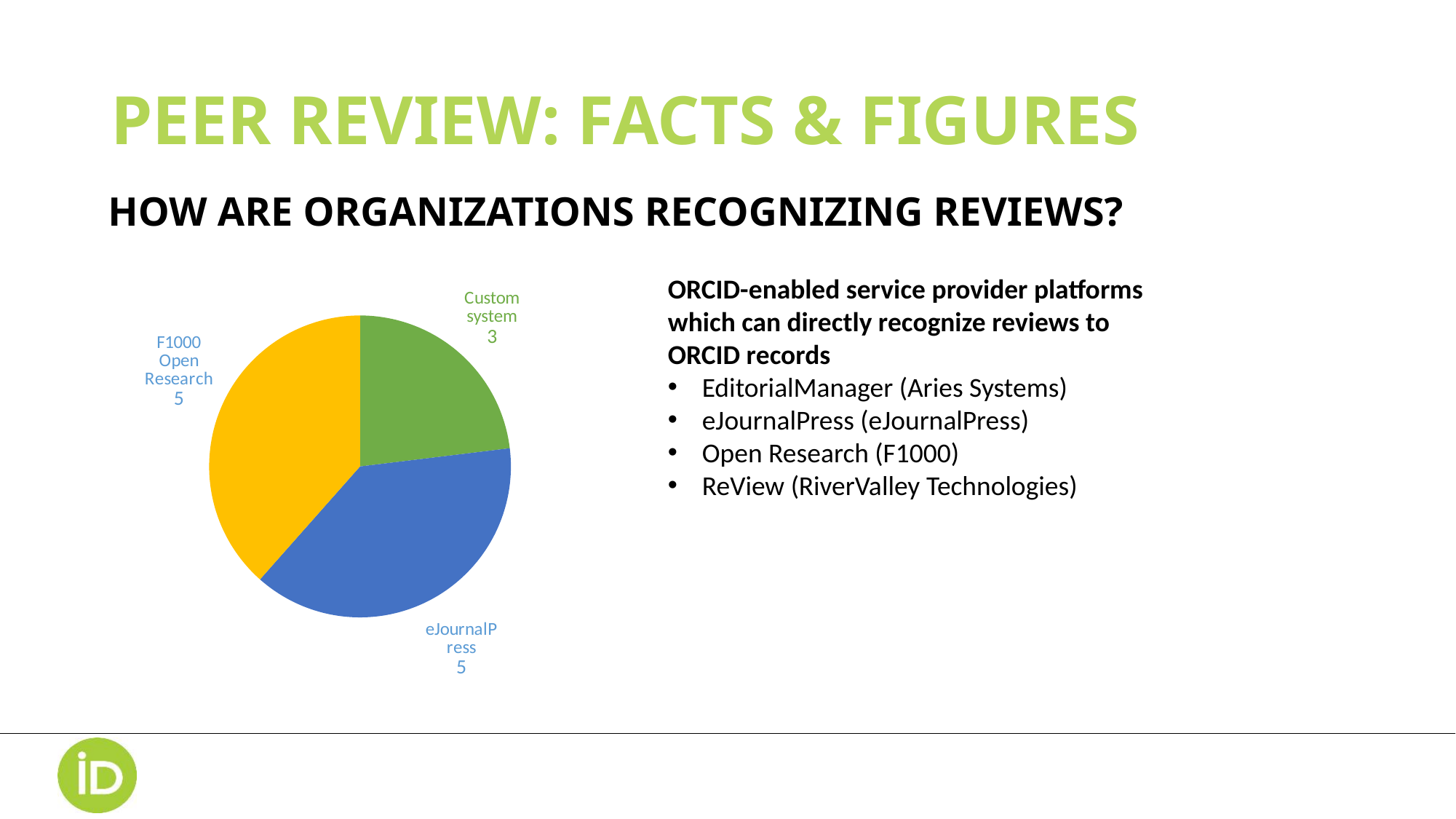
Which category has the smallest slice in the pie chart? Custom system Do the F1000 Open Research and eJournalPress slices have the same value? Yes What is the total of all the values shown in the pie chart? 13 What kind of chart is shown on the slide? Pie chart What colour is the F1000 Open Research slice? Yellow What value is shown for the F1000 Open Research slice? 5 How many slices does the pie chart have? 3 Which is larger, the eJournalPress slice or the Custom system slice? eJournalPress What is the difference between the F1000 Open Research value and the Custom system value? 2 What colour is the Custom system slice? Green What value is shown for the Custom system slice of the pie chart? 3 What value is shown for the eJournalPress slice? 5